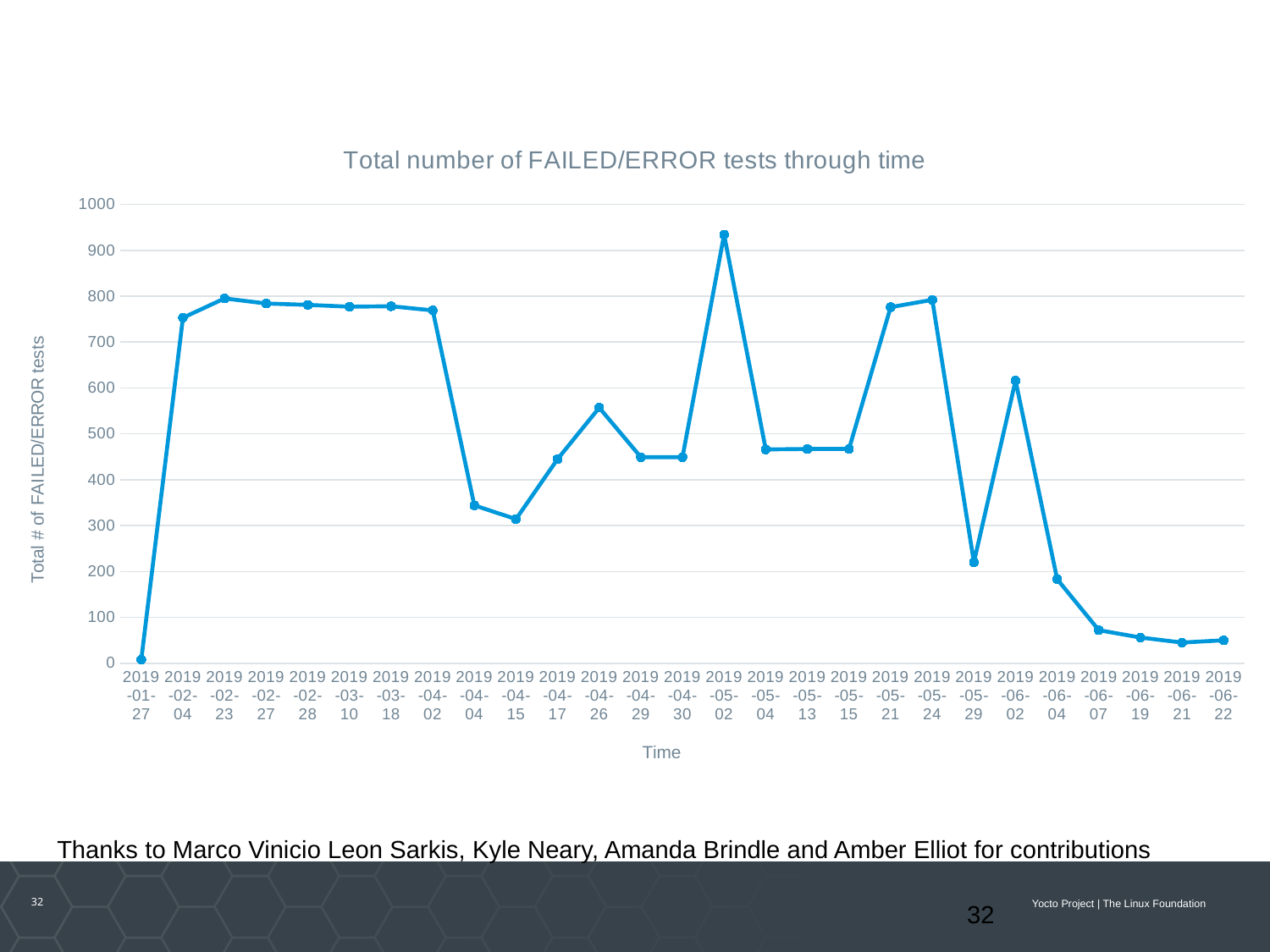
Which date has the larger value, 2019-06-02 or 2019-06-04? 2019-06-02 Is the value for 2019-04-15 greater or less than 400? less On which date is the total number of FAILED/ERROR tests lowest? 2019-01-27 What is the label of the vertical axis? Total # of FAILED/ERROR tests What kind of chart is shown on the slide? Line chart How many dates are plotted along the x axis? 27 Is the value for 2019-06-22 greater or less than 100? less On which date is the total number of FAILED/ERROR tests highest? 2019-05-02 Do the values rise or fall from 2019-06-02 to 2019-06-22? fall Is the value for 2019-05-02 greater or less than 900? greater What is the title of the chart? Total number of FAILED/ERROR tests through time